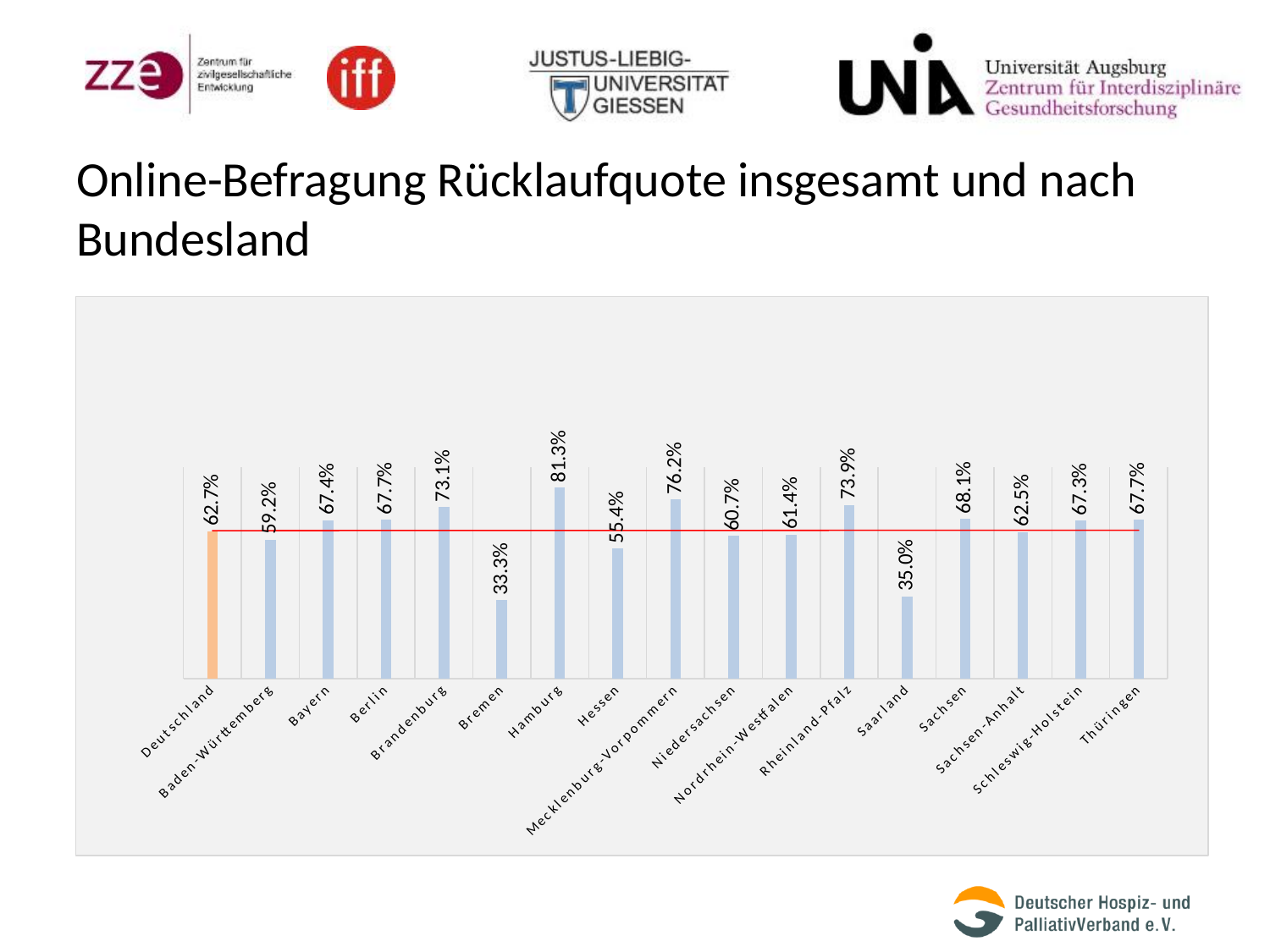
Which bar is coloured differently (orange) from the others? Deutschland What is the value shown for Deutschland? 62.7% What kind of chart is shown on the slide? Bar chart How many bars are shown in the chart? 17 Which Bundesland has the highest response rate? Hamburg What is the difference between the values for Brandenburg and Bayern? 5.7 percentage points What is the value shown for Mecklenburg-Vorpommern? 76.2% Which has a higher value, Rheinland-Pfalz or Sachsen? Rheinland-Pfalz What is the difference between the values for Hamburg and Bremen? 48.0 percentage points Which Bundesland has the lowest response rate? Bremen What is the response rate shown for Hamburg? 81.3% What is the value shown for Saarland? 35.0%